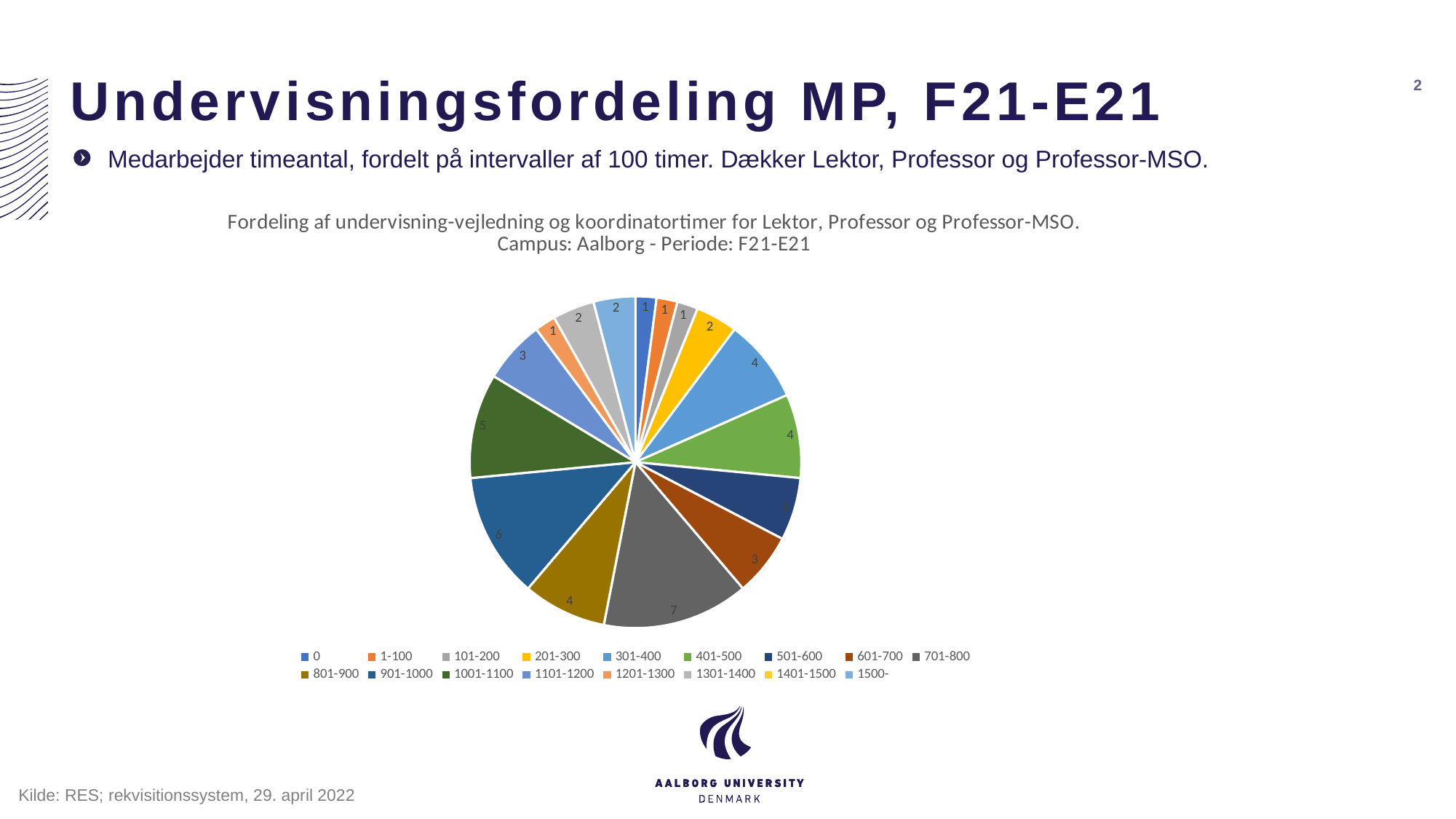
How many categories does the legend of the pie chart list? 17 What is the difference between the value for 701-800 and the value for 801-900? 3 What is the value for the 1001-1100 category? 5 What is the value for the 901-1000 category? 6 What is the value for the 301-400 category? 4 Which campus and period are named in the chart title? Campus: Aalborg - Periode: F21-E21 What type of chart is shown on the slide? pie chart Which category has the largest slice in the pie chart? 701-800 What is the value for the 1201-1300 category? 1 What is the value for the 601-700 category? 3 Which is larger, the value for 901-1000 or the value for 1001-1100? 901-1000 What is the value for the 701-800 category? 7